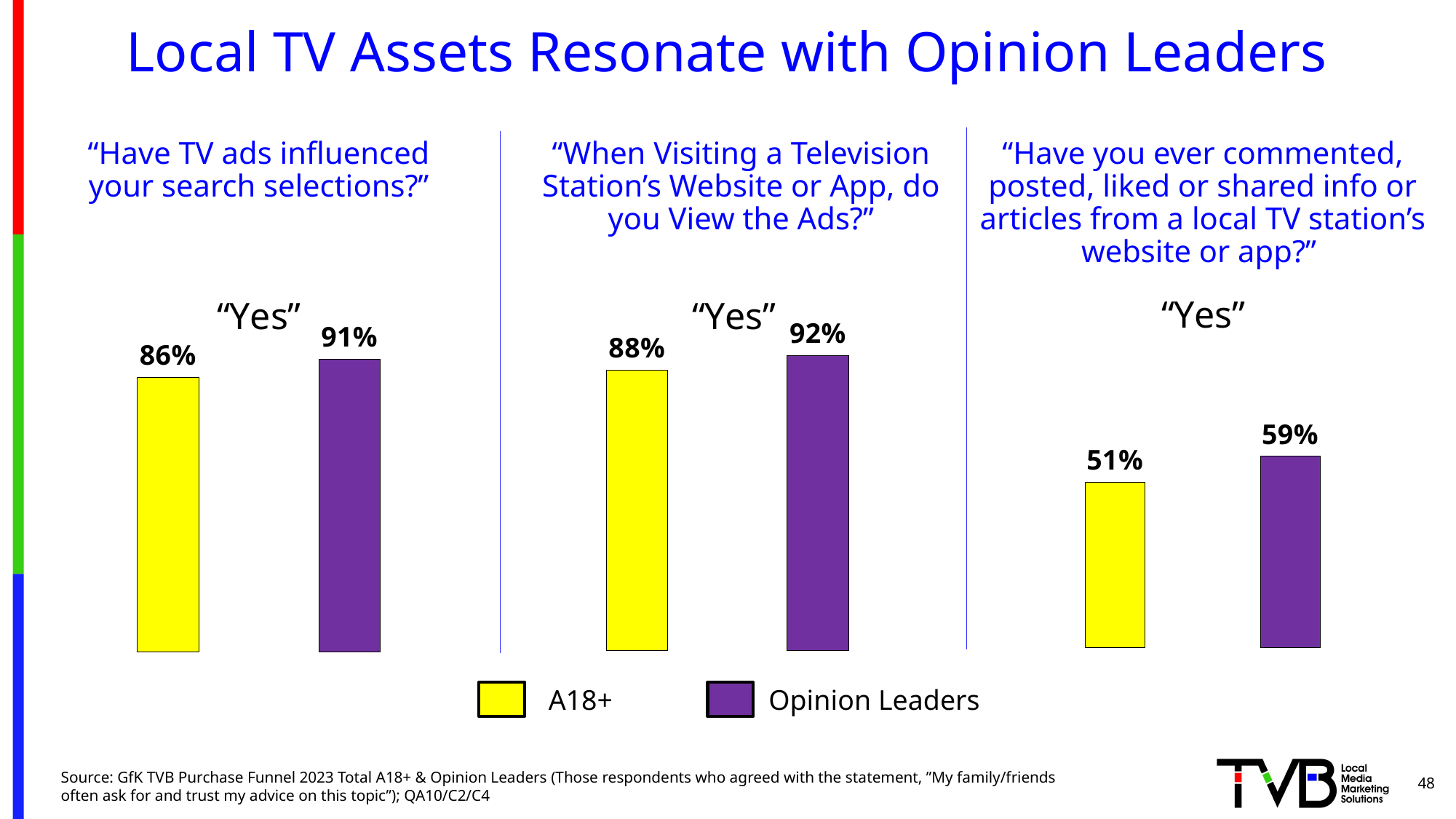
In the left chart ("Have TV ads influenced your search selections?"), what is the difference between the Opinion Leaders value and the A18+ value? 5% In the left chart ("Have TV ads influenced your search selections?"), what percentage of Opinion Leaders answered "Yes"? 91% How many series does the legend list? 2 In the right chart ("Have you ever commented, posted, liked or shared..."), what is the difference between the Opinion Leaders value and the A18+ value? 8% In the middle chart ("When Visiting a Television Station's Website or App, do you View the Ads?"), what is the value for A18+? 88% In the middle chart ("When Visiting a Television Station's Website or App, do you View the Ads?"), what is the value for Opinion Leaders? 92% Which colour represents Opinion Leaders in the legend? Purple In the right chart ("Have you ever commented, posted, liked or shared info or articles from a local TV station's website or app?"), what is the value for A18+? 51% In the middle chart ("When Visiting a Television Station's Website or App, do you View the Ads?"), which group has the higher value, A18+ or Opinion Leaders? Opinion Leaders In the left chart ("Have TV ads influenced your search selections?"), what percentage of A18+ answered "Yes"? 86% In the right chart ("Have you ever commented, posted, liked or shared info or articles from a local TV station's website or app?"), what is the value for Opinion Leaders? 59% What type of chart is used on this slide? Bar chart